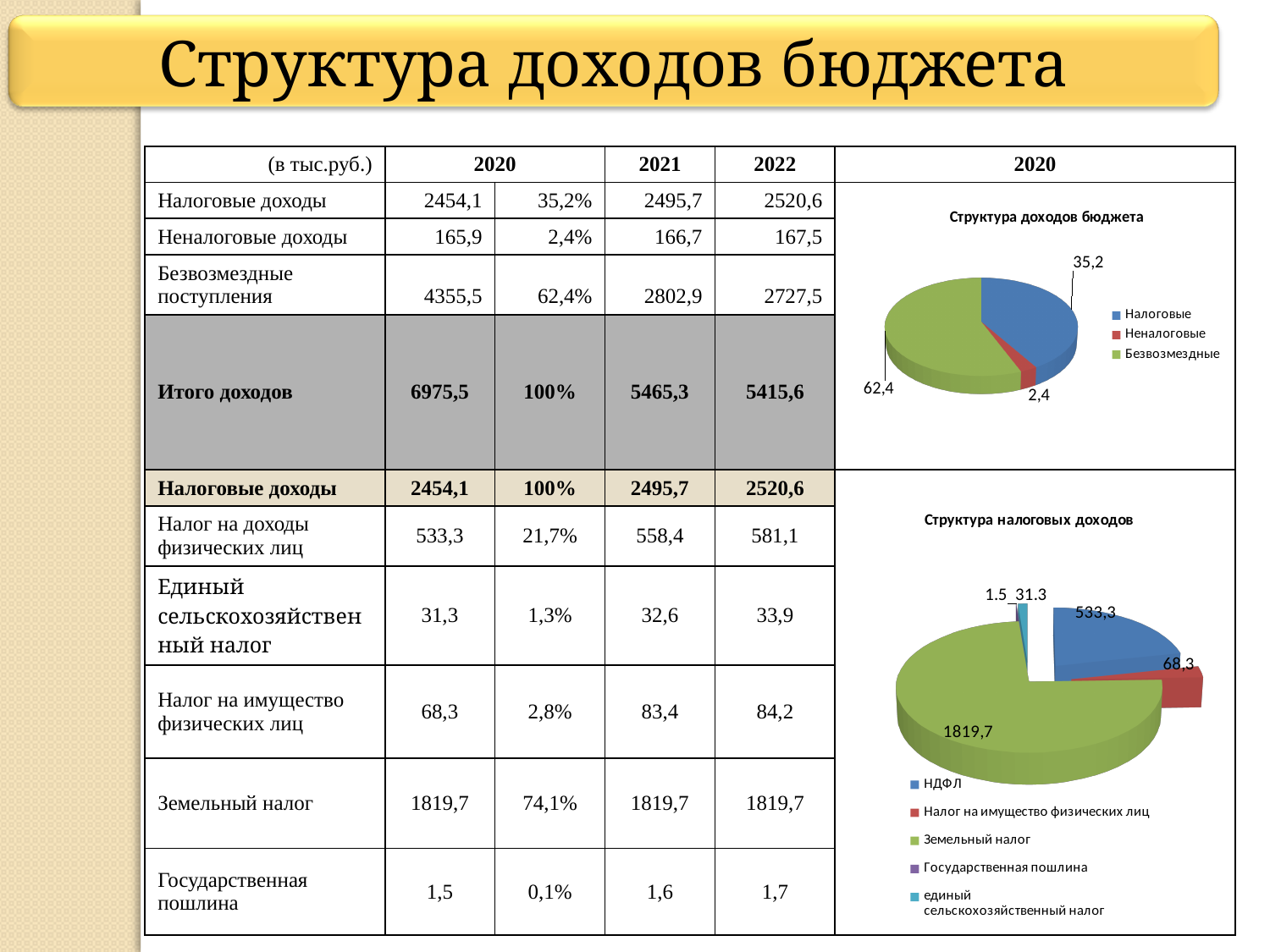
In the chart titled "Структура налоговых доходов", which category has the largest slice? Земельный налог How many entries does the legend of the chart titled "Структура налоговых доходов" list? 5 In the chart titled "Структура налоговых доходов", what value is shown for НДФЛ? 533,3 What kind of chart is "Структура налоговых доходов"? Pie chart In the chart titled "Структура доходов бюджета", how many slices does the pie have? 3 In the chart titled "Структура доходов бюджета", which category has the smallest slice? Неналоговые In the chart titled "Структура налоговых доходов", which is larger: НДФЛ or Налог на имущество физических лиц? НДФЛ In the chart titled "Структура доходов бюджета", what value is shown for the Неналоговые slice? 2,4 In the chart titled "Структура налоговых доходов", what value is shown for Земельный налог? 1819,7 In the chart titled "Структура доходов бюджета", what value is shown for the Налоговые slice? 35,2 In the chart titled "Структура доходов бюджета", which category has the largest slice? Безвозмездные In the chart titled "Структура доходов бюджета", what value is shown for the Безвозмездные slice? 62,4